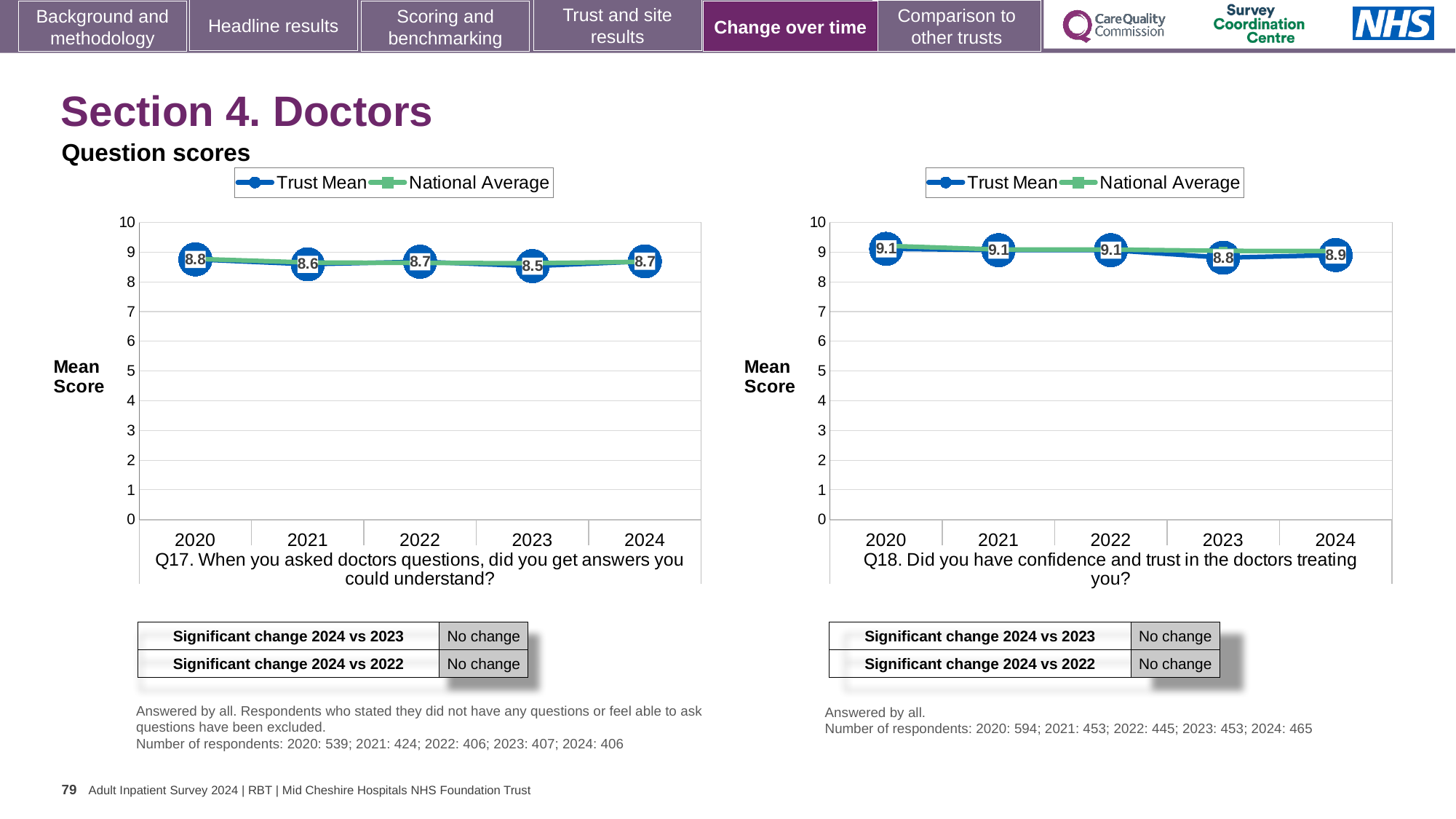
What kind of chart is the Q17 chart? line chart On the Q17 chart, which year has the highest Trust Mean score? 2020 On the Q17 chart, which year has the lowest Trust Mean score? 2023 How many years are plotted on the Q18 chart? 5 On the Q17 chart, what is the Trust Mean score for 2023? 8.5 On the Q18 chart, is the Trust Mean score for 2022 larger or smaller than the score for 2023? larger On the Q18 chart, what is the Trust Mean score for 2024? 8.9 On the Q17 chart, what is the difference between the Trust Mean scores for 2020 and 2023? 0.3 On the Q17 chart, what is the Trust Mean score for 2020? 8.8 On the Q18 chart, which year has the lowest Trust Mean score? 2023 How many series does the legend of the Q17 chart list? 2 On the Q18 chart, what is the Trust Mean score for 2023? 8.8